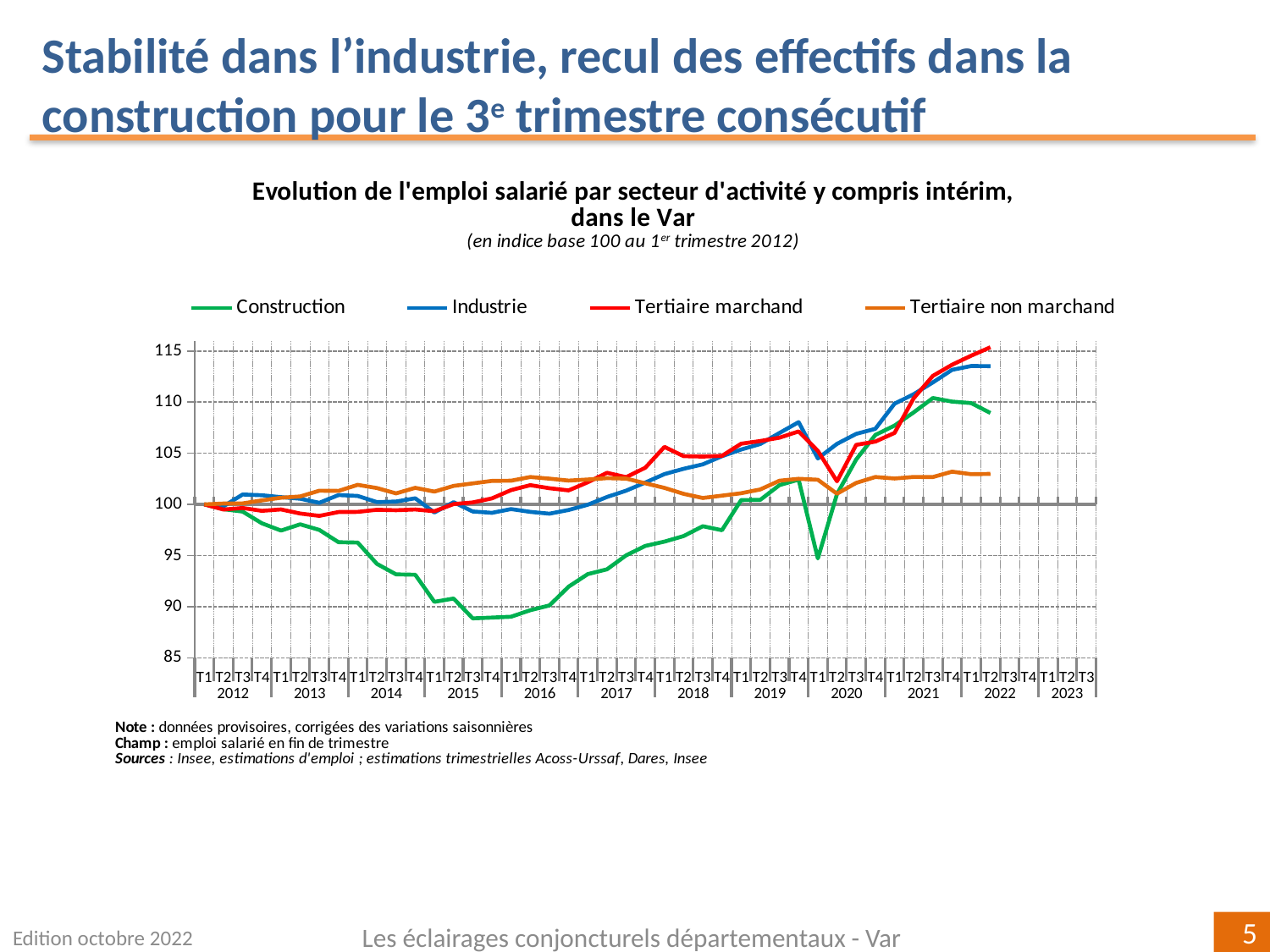
What is the base value of the index at T1 2012 for all series? 100 Is the value for Tertiaire non marchand at T2 2022 greater or less than 105? less Does the Construction series rise or fall between T1 2016 and T4 2019? rise Is the value for Industrie at T2 2022 greater or less than 110? greater Which series has the lowest value at T2 2022? Tertiaire non marchand Which series has the highest value at T2 2022? Tertiaire marchand Is the value for Construction at T3 2015 greater or less than 95? less What kind of chart is shown on the slide? line chart How many series does the legend list? 4 Which series is drawn in green? Construction Which series has the lowest value during 2015? Construction